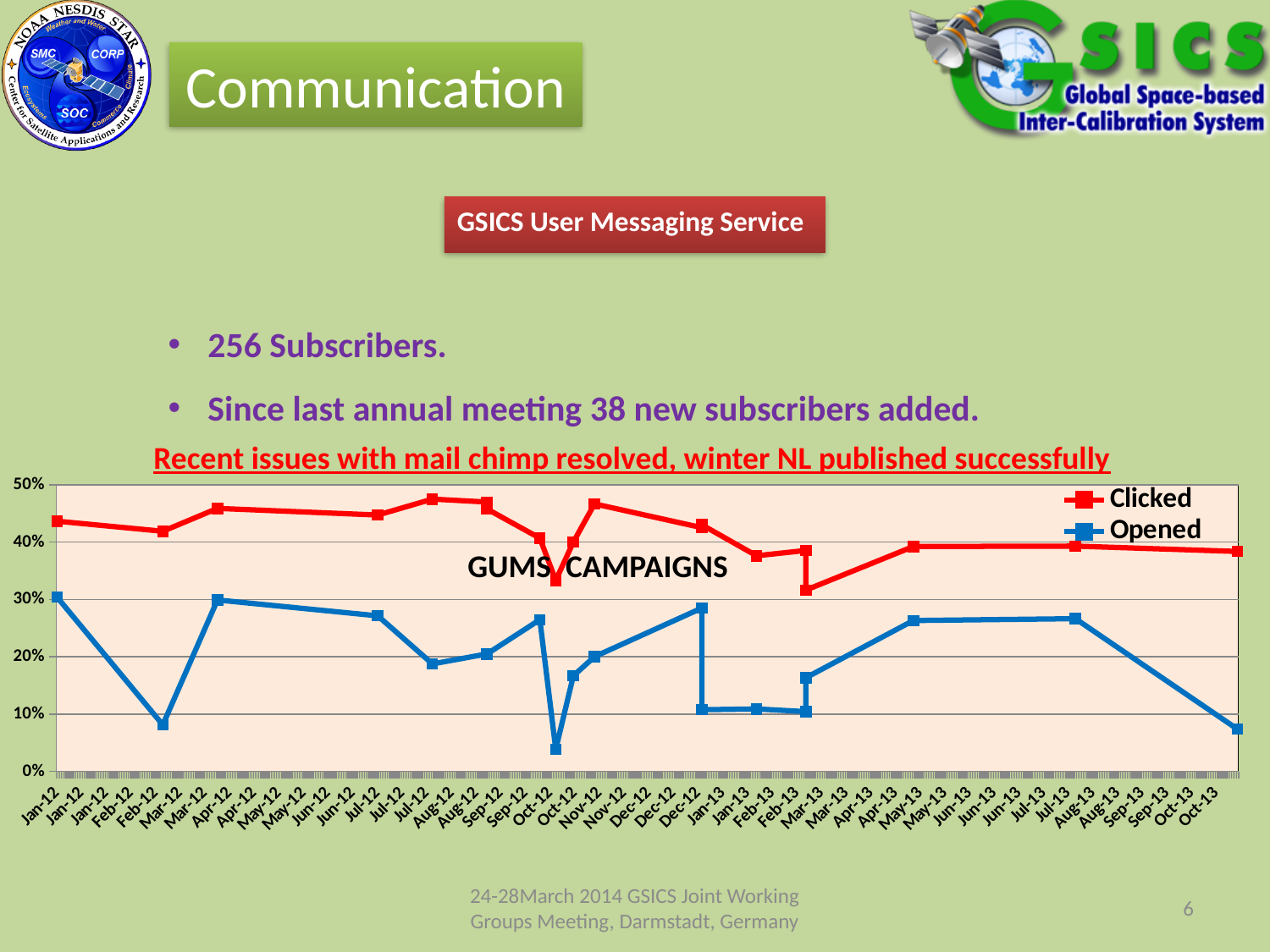
Is the Opened value for Oct-13 greater or less than 10%? less Which series is drawn in red in the chart? Clicked What is the highest value shown on the chart's vertical axis? 50% Does the Opened series rise or fall from Jul-13 to Oct-13? Fall Is the Clicked value for Jan-12 greater or less than 40%? greater Is the Opened value for Feb-12 greater or less than 10%? less How many series does the chart legend list? 2 What kind of chart is shown on the slide? Line chart At Jan-12, which series has the larger value, Clicked or Opened? Clicked At which month does the Opened series reach its lowest value? Oct-12